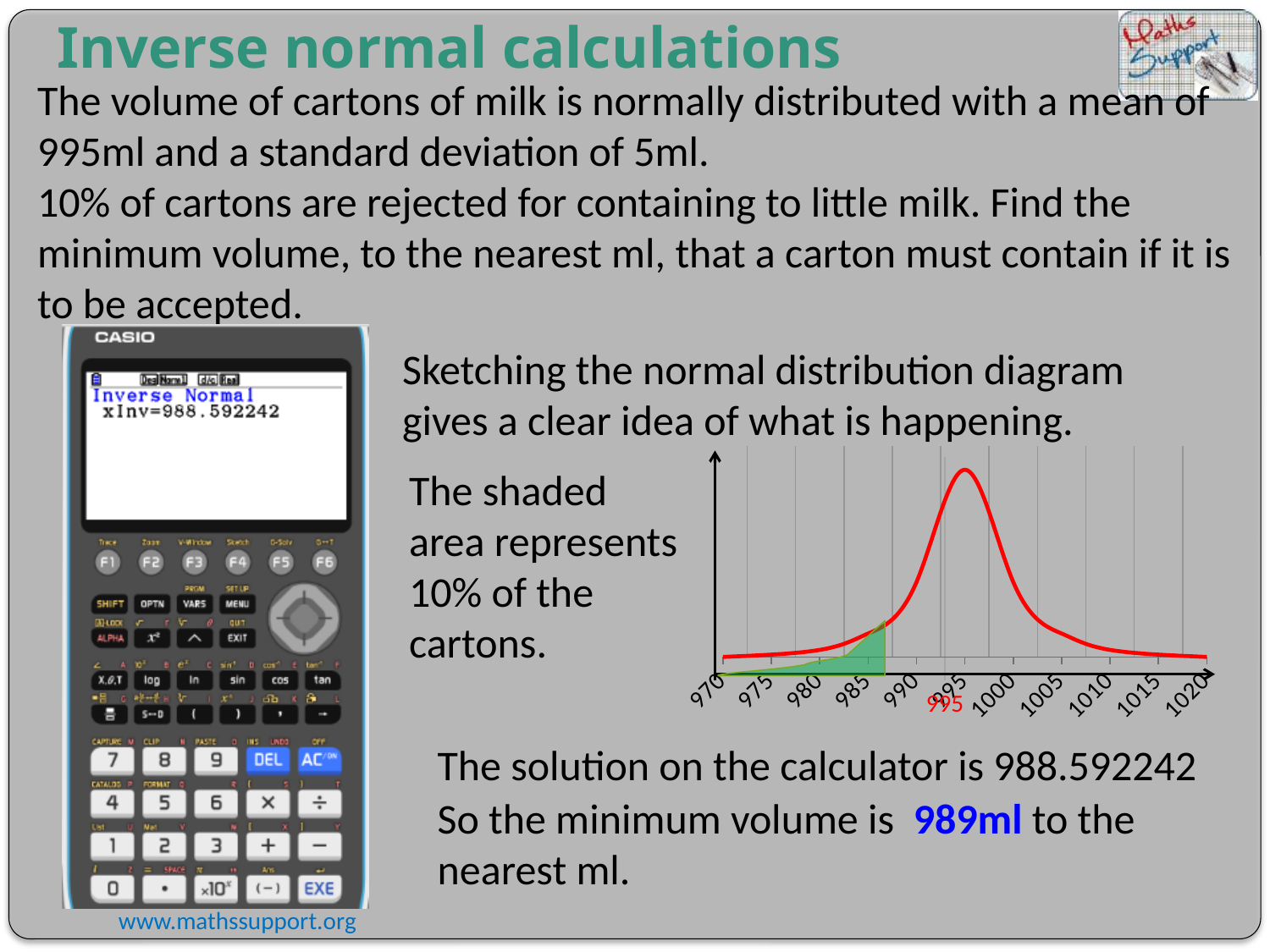
What is the lowest value labelled on the x axis of the diagram? 970 What percentage of the cartons does the shaded area under the curve represent? 10% How many labelled tick values are there on the x axis of the normal distribution diagram? 11 What kind of chart is shown on the slide? A normal distribution curve (line chart) Does the curve rise or fall as x increases from 970 to 995? rise At which x-axis value does the curve reach its peak? 995 Is the shaded region under the curve located at values less or greater than 990? less What colour is the shaded area under the curve? Green What is the highest value labelled on the x axis of the diagram? 1020 Does the curve rise or fall as x increases from 995 to 1020? fall Is the peak of the curve at a value greater or less than 990? greater Which x-axis value is written in red beneath the diagram? 995